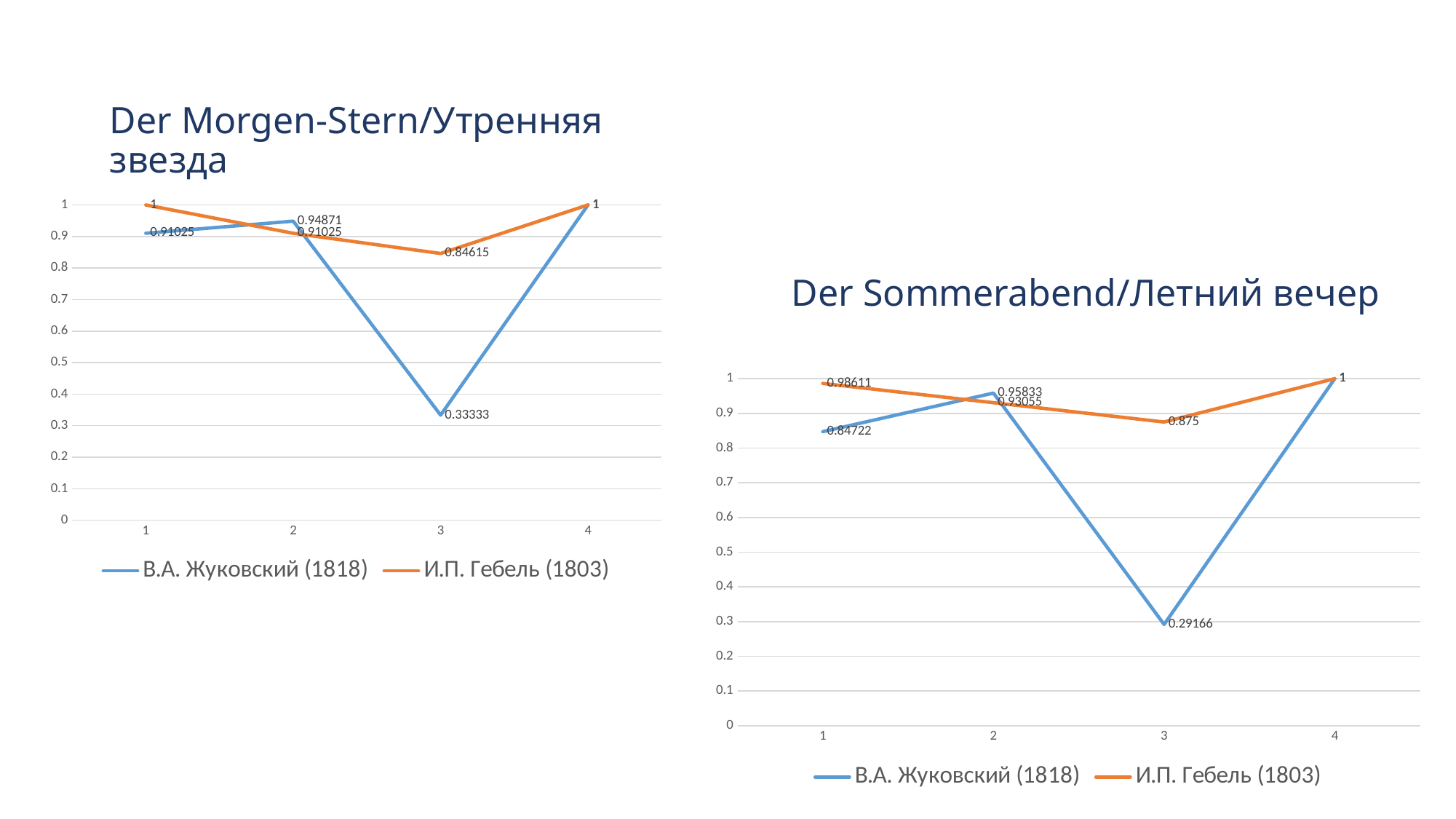
In the chart titled "Der Morgen-Stern/Утренняя звезда", what is the value for И.П. Гебель (1803) at point 3? 0.84615 In the chart titled "Der Sommerabend/Летний вечер", how many points are plotted along the x axis for each series? 4 In the chart titled "Der Morgen-Stern/Утренняя звезда", at which point is the value for В.А. Жуковский (1818) lowest? 3 In the chart titled "Der Sommerabend/Летний вечер", what is the value for В.А. Жуковский (1818) at point 1? 0.84722 In the chart titled "Der Morgen-Stern/Утренняя звезда", what is the value for В.А. Жуковский (1818) at point 3? 0.33333 In the chart titled "Der Morgen-Stern/Утренняя звезда", how many series does the legend list? 2 In the chart titled "Der Sommerabend/Летний вечер", which series has the larger value at point 1? И.П. Гебель (1803) In the chart titled "Der Morgen-Stern/Утренняя звезда", which series has the larger value at point 2? В.А. Жуковский (1818) In the chart titled "Der Morgen-Stern/Утренняя звезда", what is the difference between the И.П. Гебель (1803) and В.А. Жуковский (1818) values at point 3? 0.51282 In the chart titled "Der Sommerabend/Летний вечер", what is the value for И.П. Гебель (1803) at point 3? 0.875 In the chart titled "Der Sommerabend/Летний вечер", at which point is the value for В.А. Жуковский (1818) lowest? 3 What kind of chart is the one titled "Der Sommerabend/Летний вечер"? Line chart